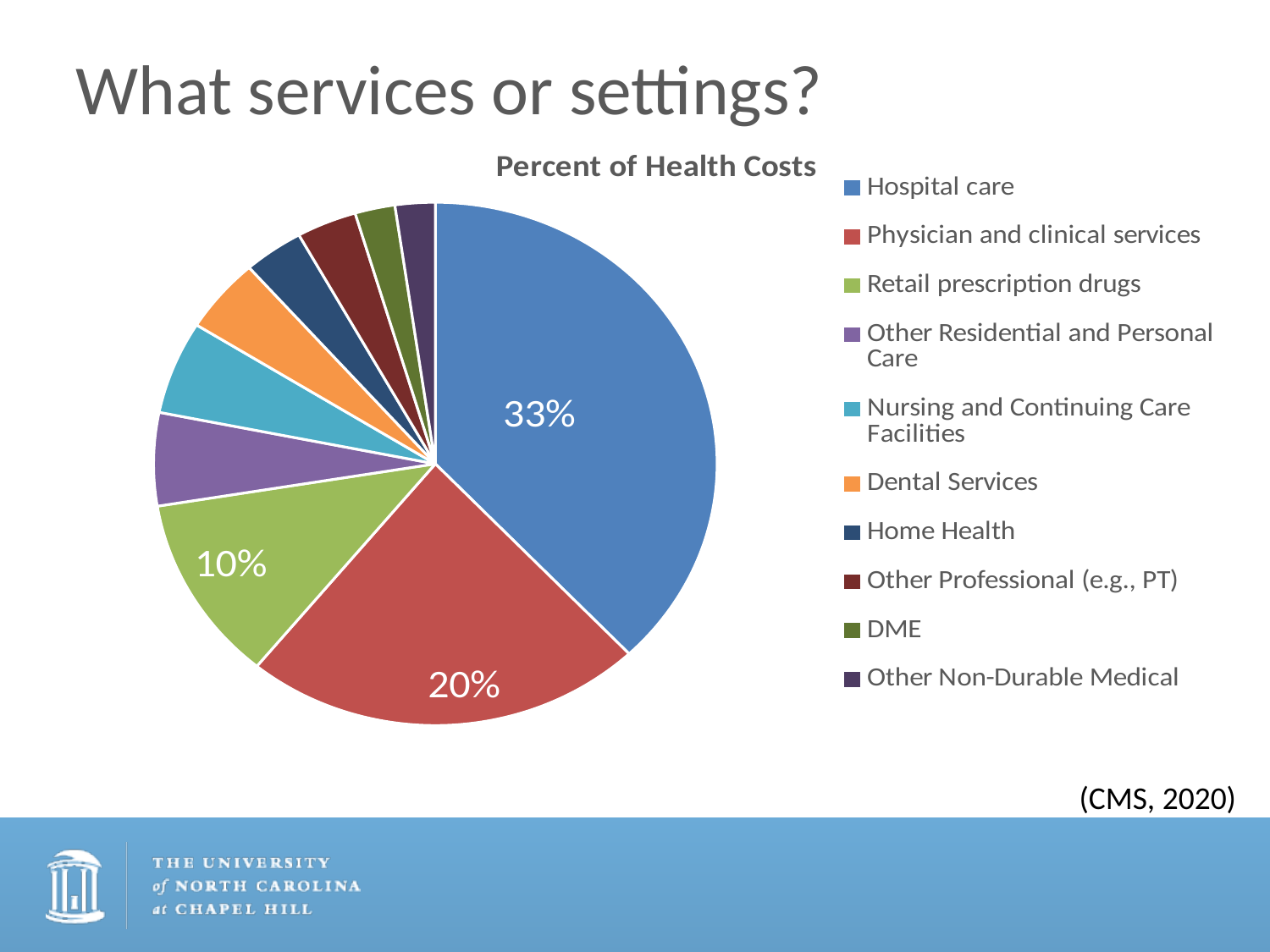
What percentage of health costs is attributed to Retail prescription drugs? 10% What is the title of the chart? Percent of Health Costs Which category accounts for the largest share of health costs? Hospital care By how many percentage points does the Physician and clinical services share exceed the Retail prescription drugs share? 10 percentage points Which is larger: the share for Retail prescription drugs or the share for Dental Services? Retail prescription drugs Which is larger: the share for Hospital care or the share for Physician and clinical services? Hospital care How many categories does the pie chart show? 10 What percentage of health costs is attributed to Hospital care? 33% Which category is shown in orange in the legend? Dental Services By how many percentage points does the Hospital care share exceed the Physician and clinical services share? 13 percentage points What kind of chart is shown on the slide? Pie chart What percentage of health costs is attributed to Physician and clinical services? 20%